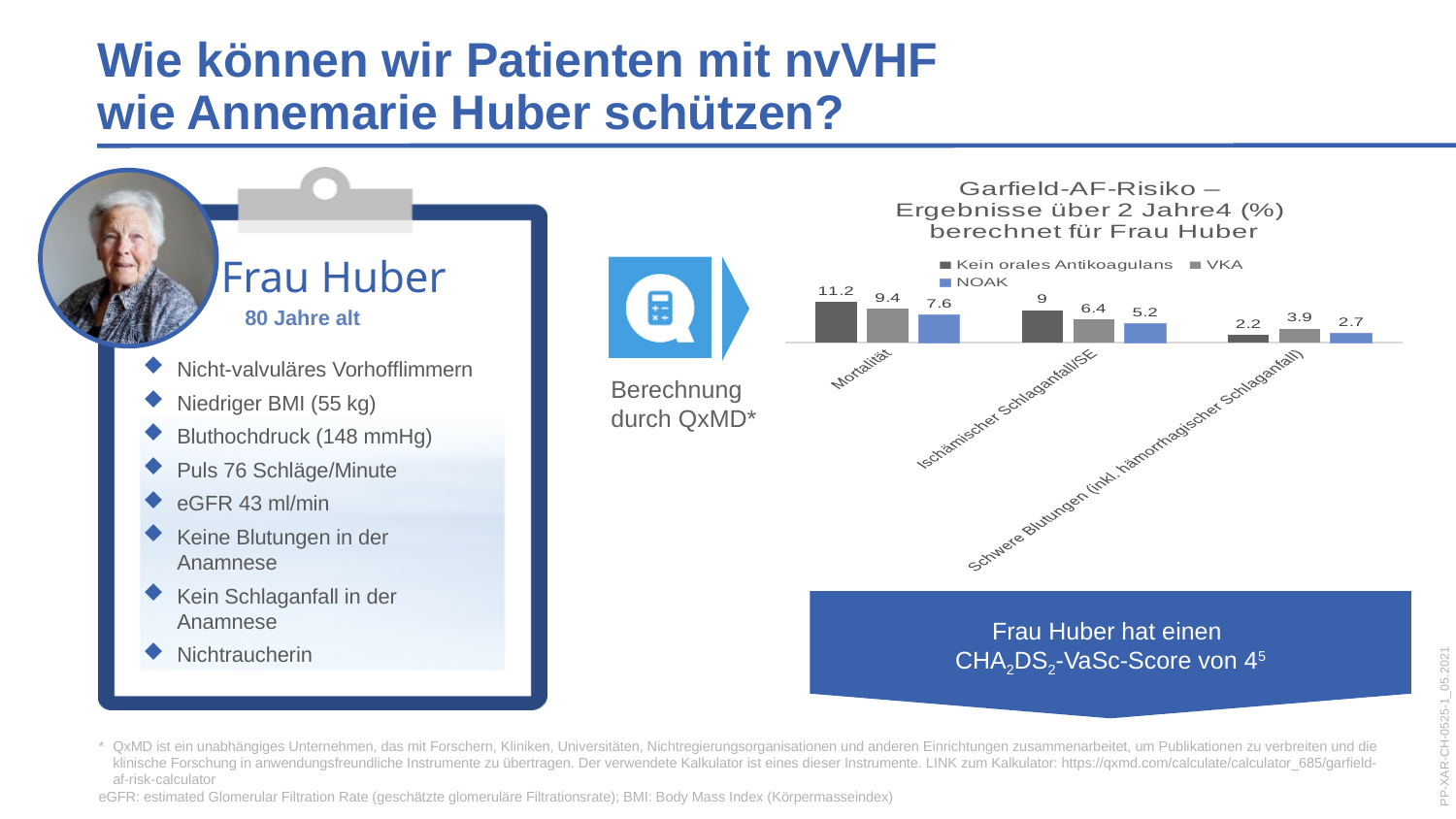
What is the value for NOAK in the Mortalität category? 7.6 How many categories are shown on the x axis of the chart? 3 Which series has the lowest value in the Schwere Blutungen (inkl. hämorrhagischer Schlaganfall) category? Kein orales Antikoagulans What is the value for Kein orales Antikoagulans in the Mortalität category? 11.2 Which series is shown in blue in the chart? NOAK What is the value for VKA in the Schwere Blutungen (inkl. hämorrhagischer Schlaganfall) category? 3.9 How many series does the chart legend list? 3 What is the value for VKA in the Ischämischer Schlaganfall/SE category? 6.4 Which series has the highest value in the Mortalität category? Kein orales Antikoagulans What is the difference between the Kein orales Antikoagulans and NOAK values in the Ischämischer Schlaganfall/SE category? 3.8 What kind of chart is shown on the slide? bar chart Which is larger in the Schwere Blutungen (inkl. hämorrhagischer Schlaganfall) category: VKA or NOAK? VKA